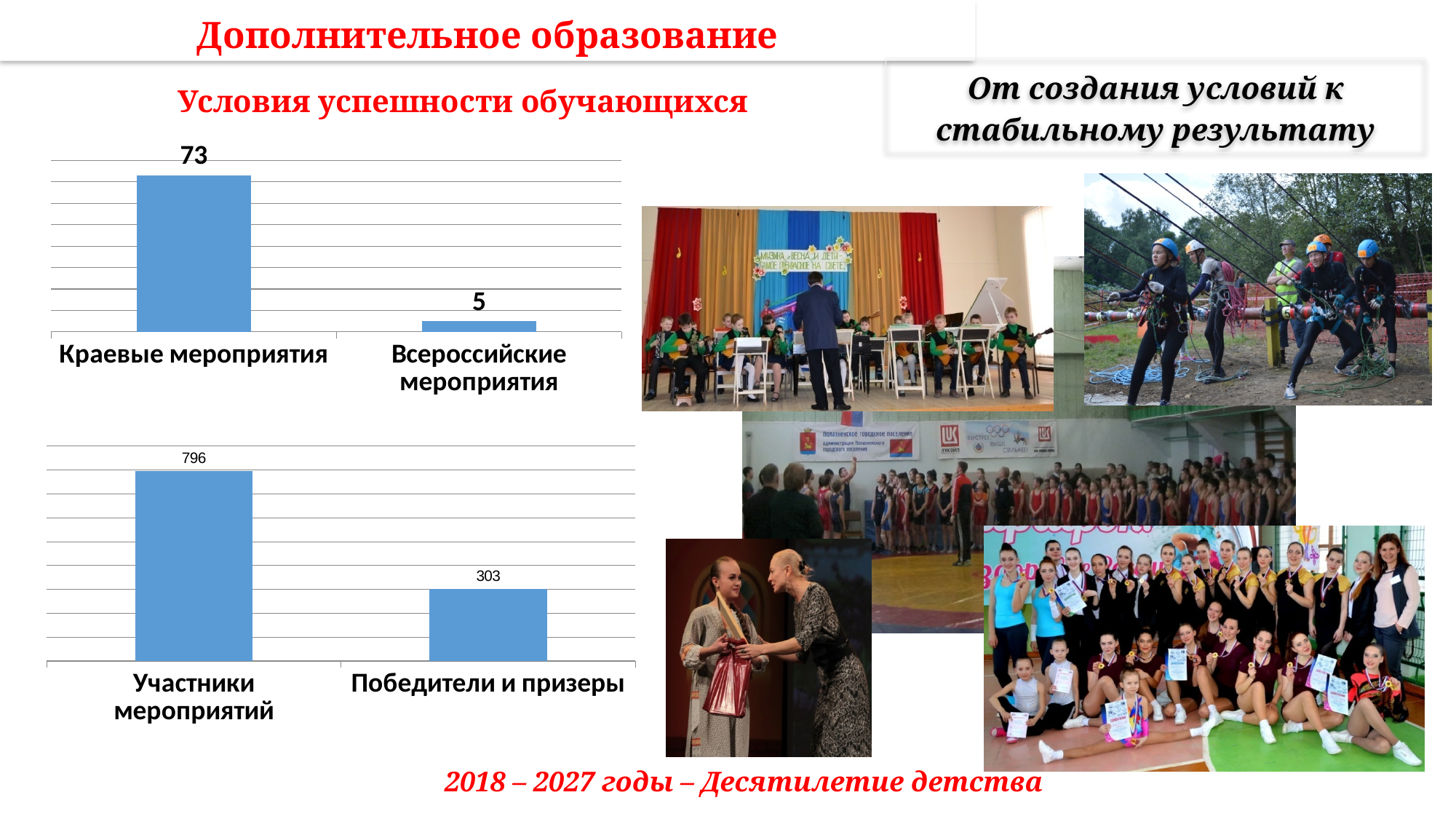
In the top chart on the left, what is the value for Краевые мероприятия? 73 In the top chart on the left, what is the value for Всероссийские мероприятия? 5 What type of chart is the top chart on the left? Bar chart In the bottom chart on the left, what is the value for Участники мероприятий? 796 In the bottom chart on the left, what is the difference between Участники мероприятий and Победители и призеры? 493 In the bottom chart on the left, which category has the lowest value? Победители и призеры In the top chart on the left, how many categories are shown? 2 In the top chart on the left, what is the difference between Краевые мероприятия and Всероссийские мероприятия? 68 In the bottom chart on the left, which is larger: Участники мероприятий or Победители и призеры? Участники мероприятий In the top chart on the left, which category has the highest value? Краевые мероприятия In the bottom chart on the left, what is the value for Победители и призеры? 303 What colour are the bars in the two charts on the left? Blue